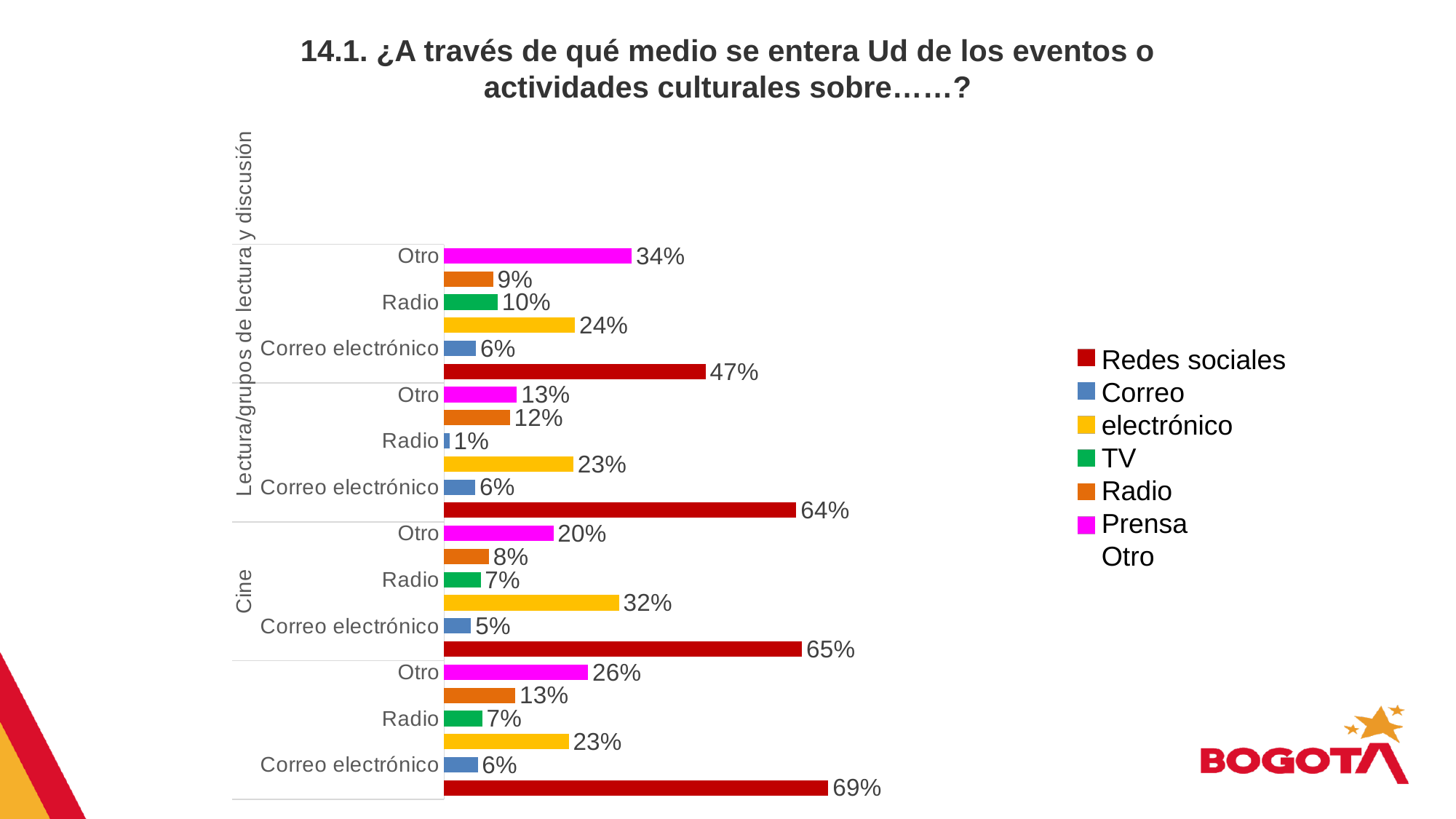
In the Cine group, which bar has the highest value? the red bar (65%) In the Lectura/grupos de lectura y discusión group, what is the value of the bar labelled Correo electrónico? 6% What is the highest value printed on the chart? 69% In the Cine group, what is the value of the red bar? 65% What kind of chart is shown on the slide? bar chart In the Cine group, which bar has the lowest value? Correo electrónico (5%) Which is larger: the Otro bar in the Cine group or the Otro bar in the Lectura/grupos de lectura y discusión group? Lectura/grupos de lectura y discusión (34%) In the Cine group, what is the value of the bar labelled Radio? 7% What is the difference between the red bar in the Cine group (65%) and the red bar in the Lectura/grupos de lectura y discusión group (47%)? 18% In the Cine group, what is the value of the yellow bar? 32% In the Lectura/grupos de lectura y discusión group, what is the value of the bar labelled Otro? 34% What is the first entry listed in the legend? Redes sociales